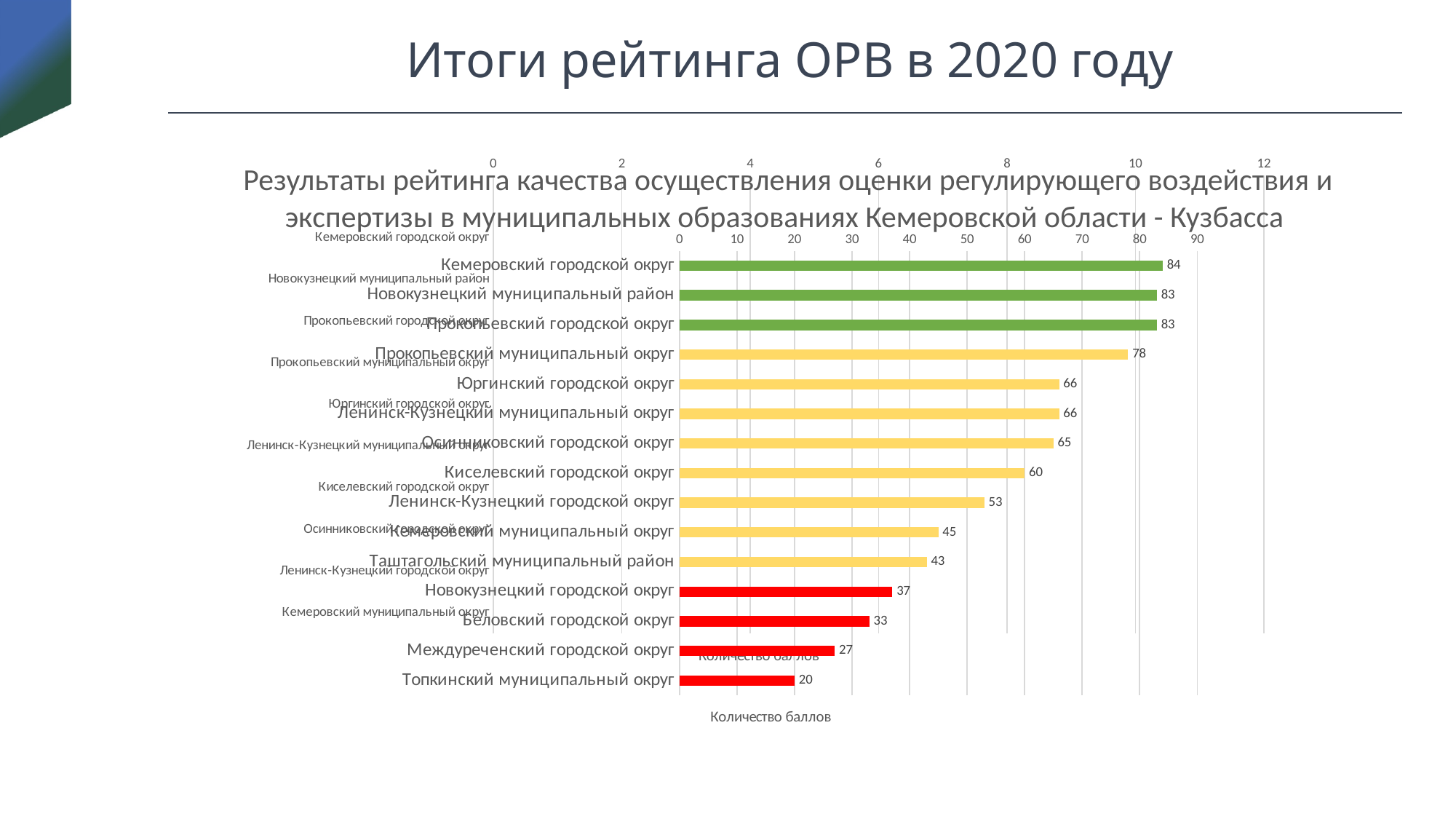
What is the difference between the values for Кемеровский городской округ and Топкинский муниципальный округ? 64 How many categories are plotted in the chart? 15 Which category has the lowest value? Топкинский муниципальный округ What type of chart is shown on the slide? bar chart What is the value for Кемеровский городской округ? 84 Which category has the highest value? Кемеровский городской округ Which is larger, the value for Беловский городской округ or the value for Междуреченский городской округ? Беловский городской округ What is the value for Таштагольский муниципальный район? 43 What is the difference between the values for Прокопьевский муниципальный округ and Новокузнецкий городской округ? 41 What is the value for Киселевский городской округ? 60 What is the value for Топкинский муниципальный округ? 20